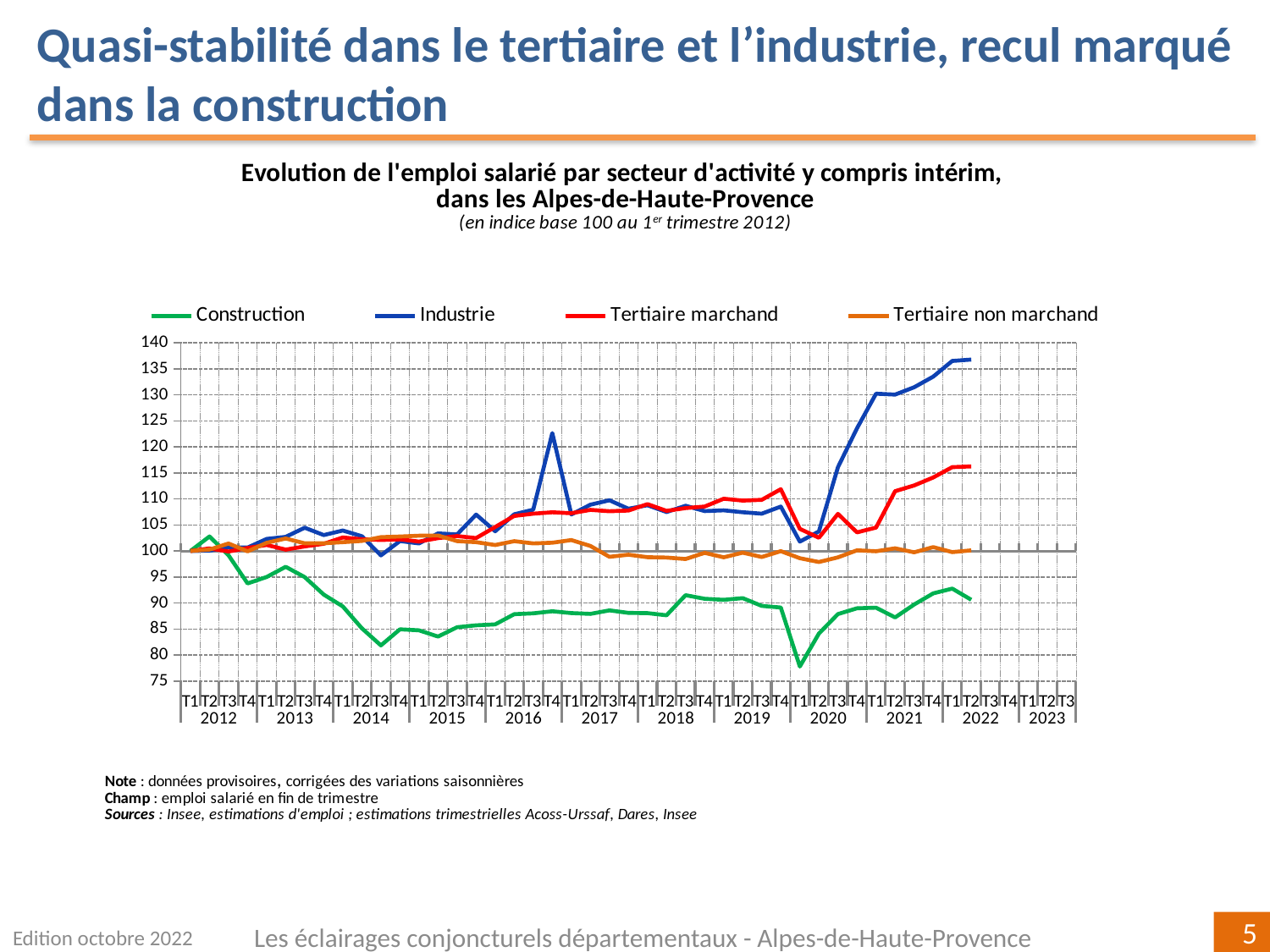
Is the value for Tertiaire marchand at T2 2022 greater or less than 110? greater Is the value for Construction at T1 2020 greater or less than 85? less Does the Industrie series rise or fall between T1 2020 and T2 2022? rise Which series has the lowest value at T2 2022? Construction At T1 2020, which is larger: Construction or Tertiaire marchand? Tertiaire marchand How many years are labelled on the x axis? 12 What colour is the Construction line? green What kind of chart is shown on the slide? line chart How many series does the legend list? 4 Which series has the highest value at T2 2022? Industrie Is the value for Industrie at T2 2022 greater or less than 130? greater